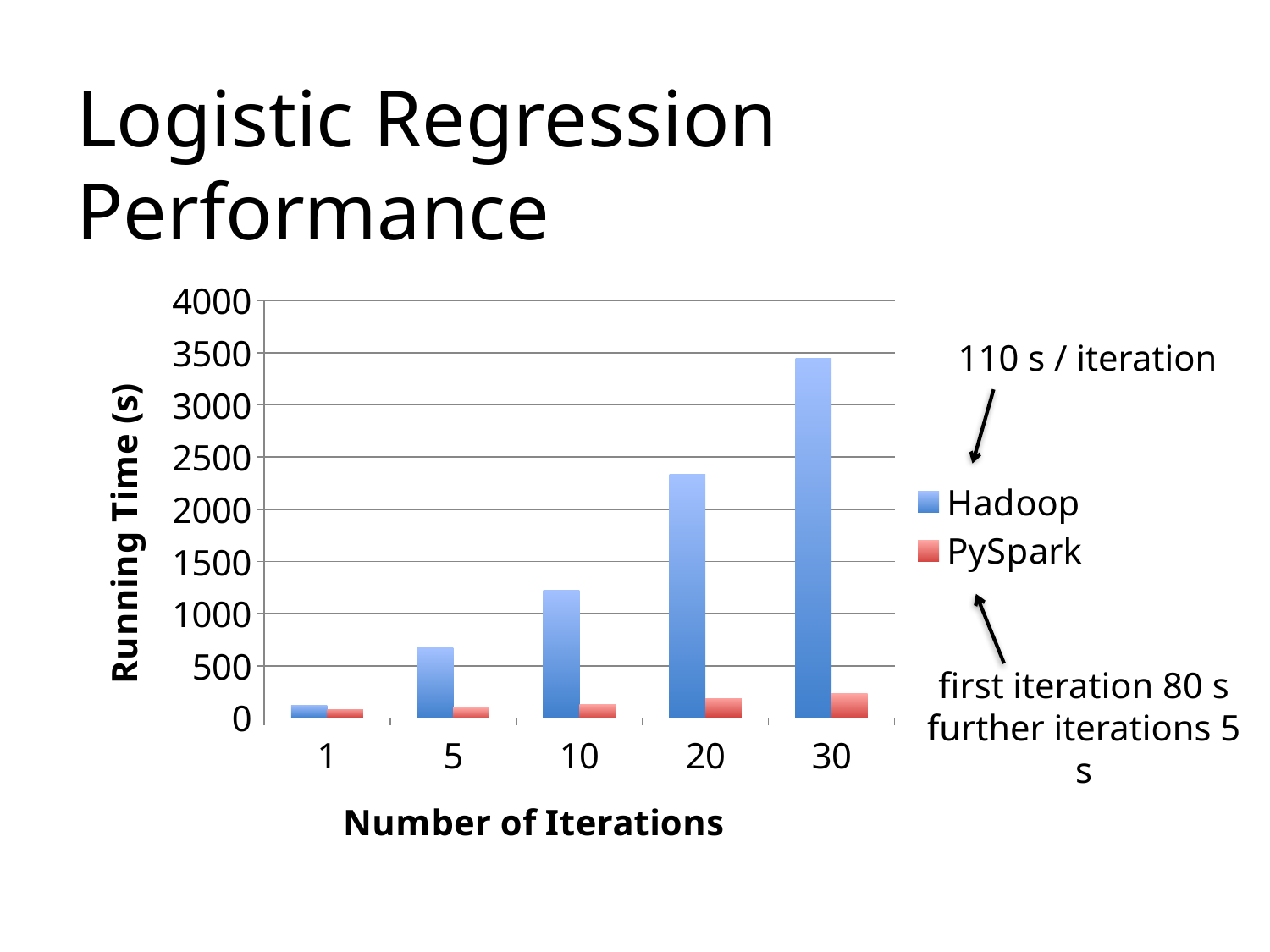
Is the Hadoop running time at 30 iterations greater or less than 3000? greater Is the Hadoop running time at 10 iterations greater or less than 1000? greater How many iteration counts are shown on the x axis? 5 How many series does the legend list? 2 At which number of iterations is the Hadoop running time lowest? 1 Does the Hadoop running time rise or fall as the number of iterations increases? rise Is the Hadoop running time at 20 iterations greater or less than 2000? greater What is the label of the vertical axis? Running Time (s) At 30 iterations, which has the larger running time, Hadoop or PySpark? Hadoop At which number of iterations is the Hadoop running time highest? 30 What kind of chart is shown on the slide? bar chart